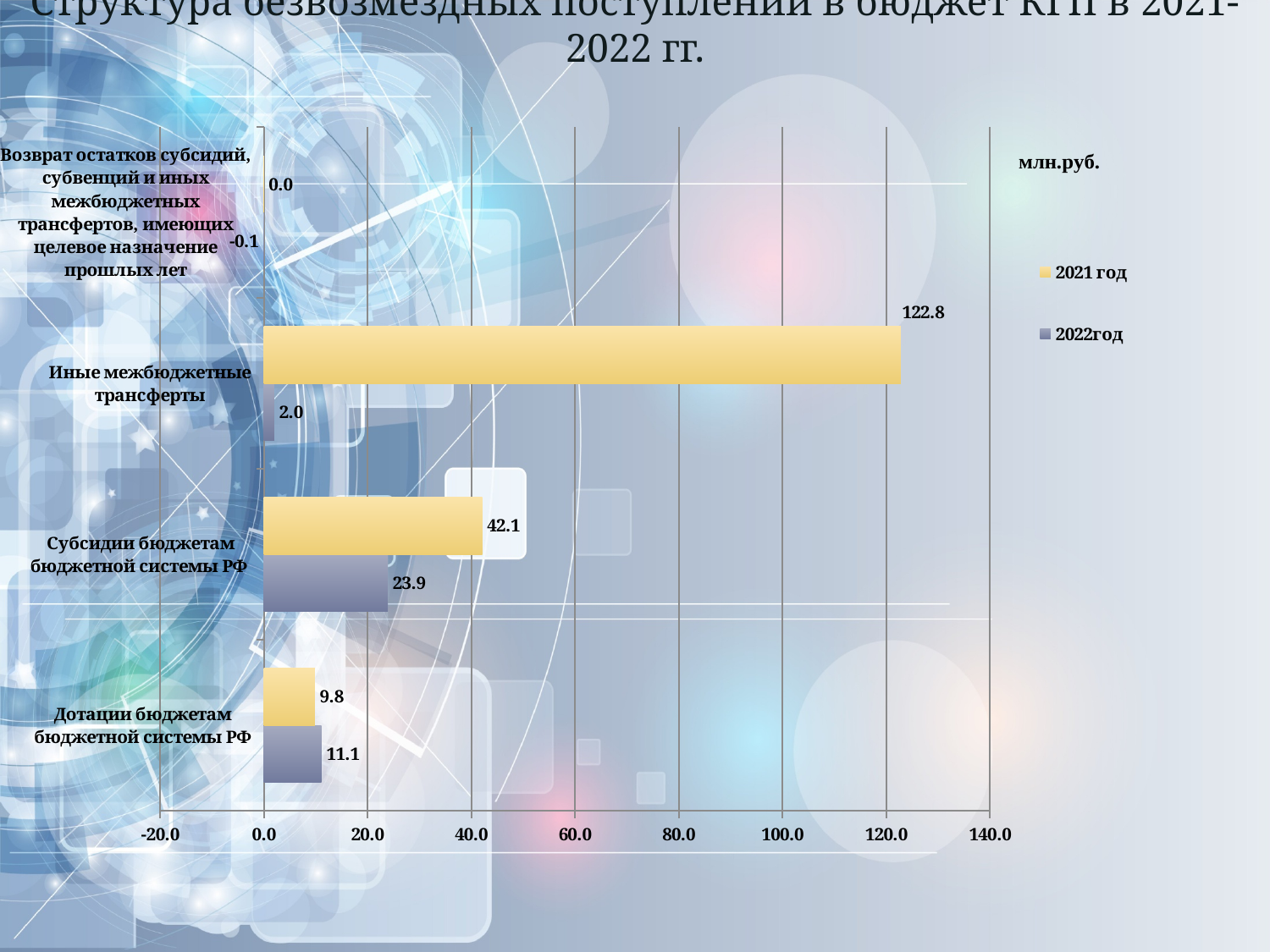
Is the 2021 год value for Иные межбюджетные трансферты greater or less than 120.0? greater What is the 2022год value for Возврат остатков субсидий, субвенций и иных межбюджетных трансфертов, имеющих целевое назначение прошлых лет? -0.1 What type of chart is shown on the slide? bar chart What is the 2022год value for Дотации бюджетам бюджетной системы РФ? 11.1 What is the 2022год value for Субсидии бюджетам бюджетной системы РФ? 23.9 Which category has the lowest 2022год value? Возврат остатков субсидий, субвенций и иных межбюджетных трансфертов, имеющих целевое назначение прошлых лет What is the difference between the 2021 год and 2022год values for Субсидии бюджетам бюджетной системы РФ? 18.2 Which category has the highest 2021 год value? Иные межбюджетные трансферты How many series does the legend list? 2 What is the 2021 год value for Иные межбюджетные трансферты? 122.8 How many categories are shown on the chart? 4 For Дотации бюджетам бюджетной системы РФ, which year has the larger value, 2021 год or 2022год? 2022год